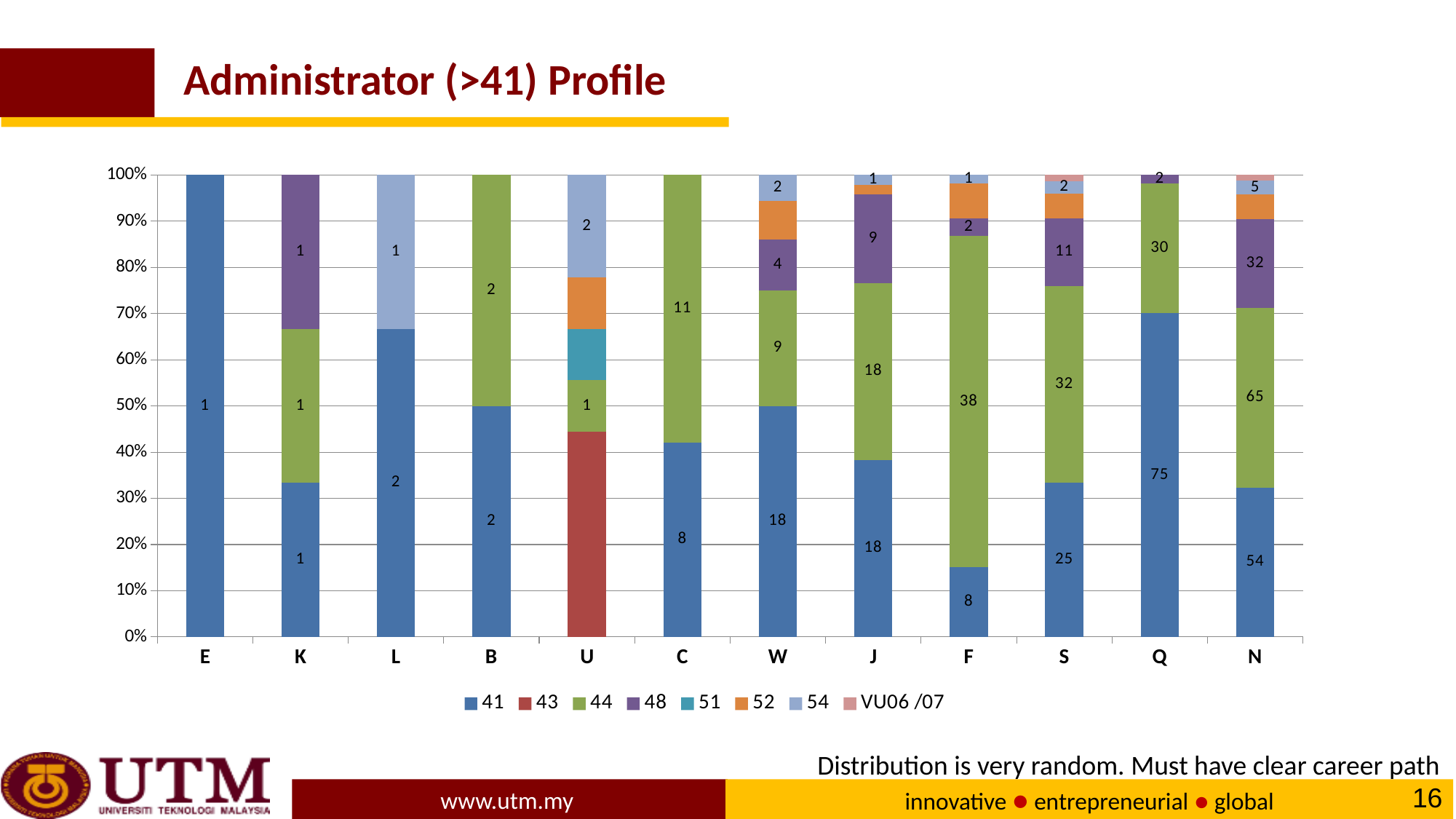
Is the share of the 41 series in the bar for category F greater or less than 20%? less What is the value of the 44 series for category F? 38 What is the value of the 48 series for category S? 11 What is the value of the 54 series for category U? 2 Which is larger for category N: the 41 series or the 44 series? 44 What kind of chart is shown on the slide? stacked bar chart What is the total of all labelled segments in the bar for category Q? 107 What is the difference between the 44 value and the 41 value for category C? 3 How many categories are shown on the x axis? 12 What is the value of the 44 series for category N? 65 How many series does the legend list? 8 What is the value of the 41 series for category Q? 75